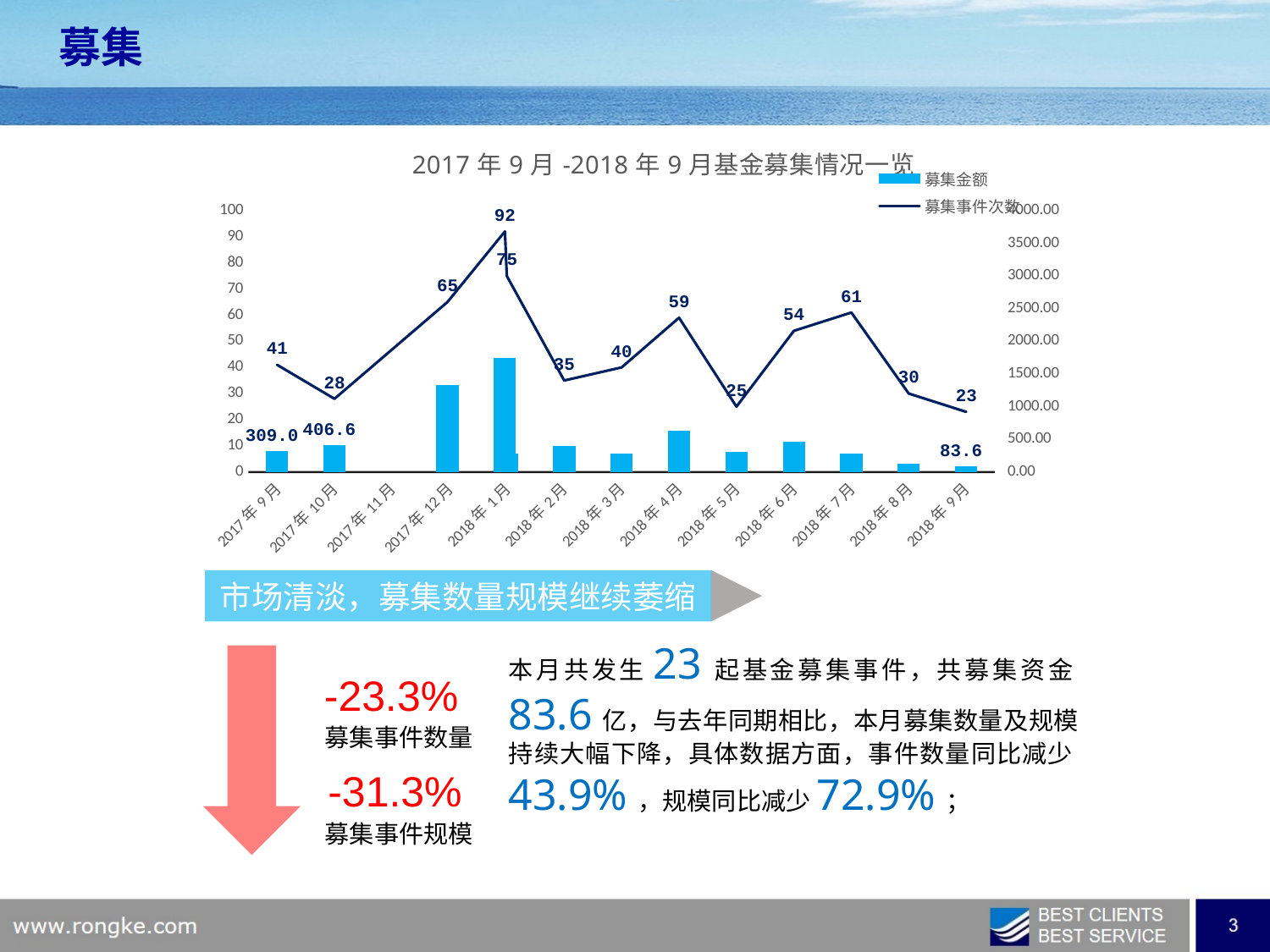
What is the 募集金额 value for 2017年10月? 406.6 Which month has the lowest 募集事件次数? 2018年9月 What is the difference in 募集事件次数 between 2017年12月 and 2018年9月? 69 What is the 募集事件次数 value for 2017年12月? 92 What kind of chart is shown on the slide? A combination bar and line chart What are the two series named in the chart legend? 募集金额 and 募集事件次数 How many months (categories) are shown on the x axis? 13 Which month has a higher 募集事件次数, 2018年4月 or 2018年6月? 2018年4月 Which month has the highest 募集事件次数? 2017年12月 What is the title of the chart? 2017年9月-2018年9月基金募集情况一览 How many series does the chart legend list? 2